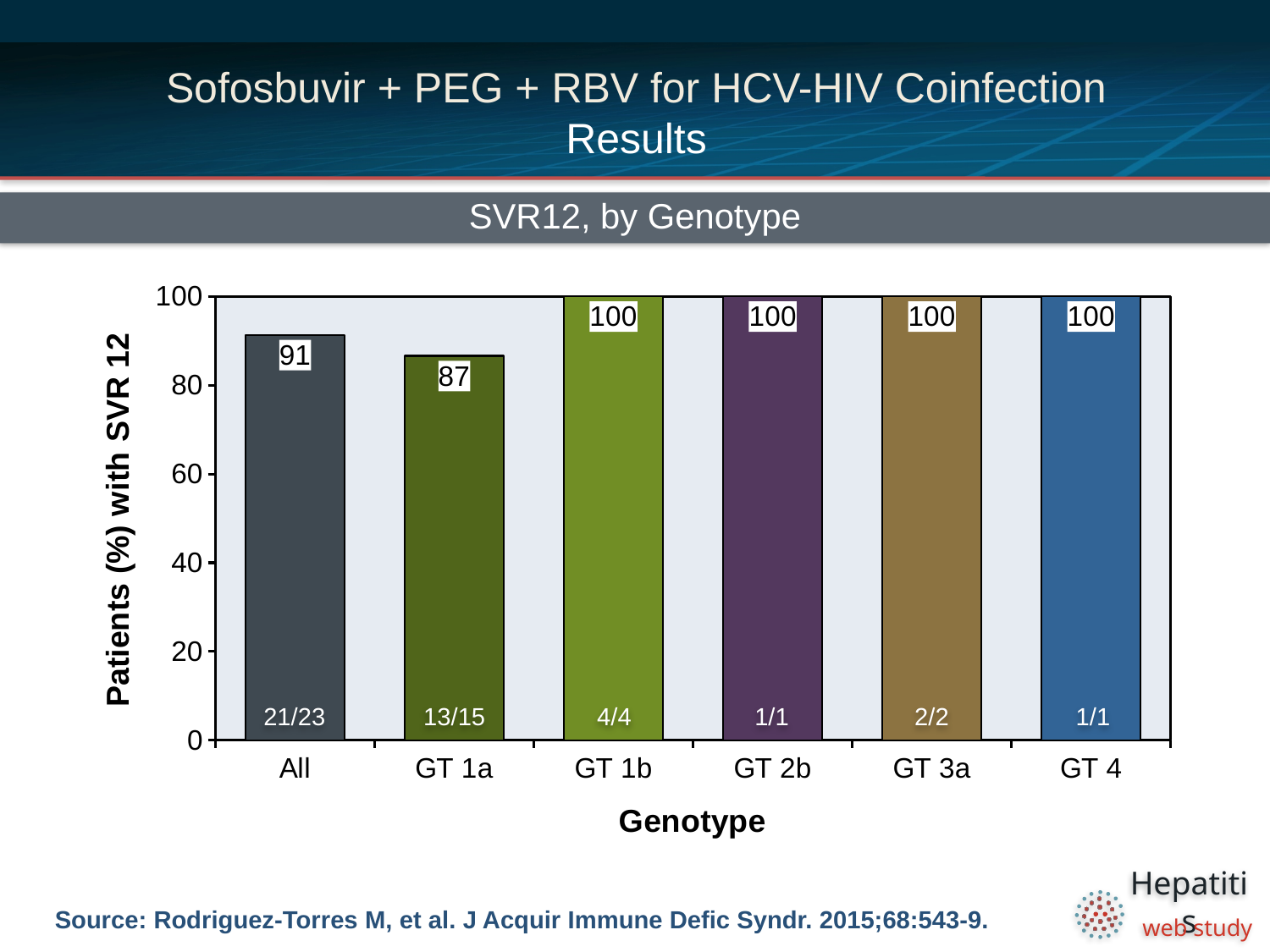
Which genotype category has the lowest SVR12 value? GT 1a What is the SVR12 value for the All group? 91 Which is larger, the SVR12 value for All or for GT 1a? All What is the difference between the SVR12 value for GT 1b and the value for GT 1a? 13 Is the SVR12 value for GT 1a greater or less than 80? greater What is the difference between the SVR12 value for All and the value for GT 1a? 4 How many categories are shown on the x axis? 6 What is the SVR12 value for GT 1a? 87 What kind of chart is shown on the slide? Bar chart What fraction of patients is shown at the base of the GT 1a bar? 13/15 What is the label of the y axis? Patients (%) with SVR 12 What fraction of patients is shown at the base of the All bar? 21/23